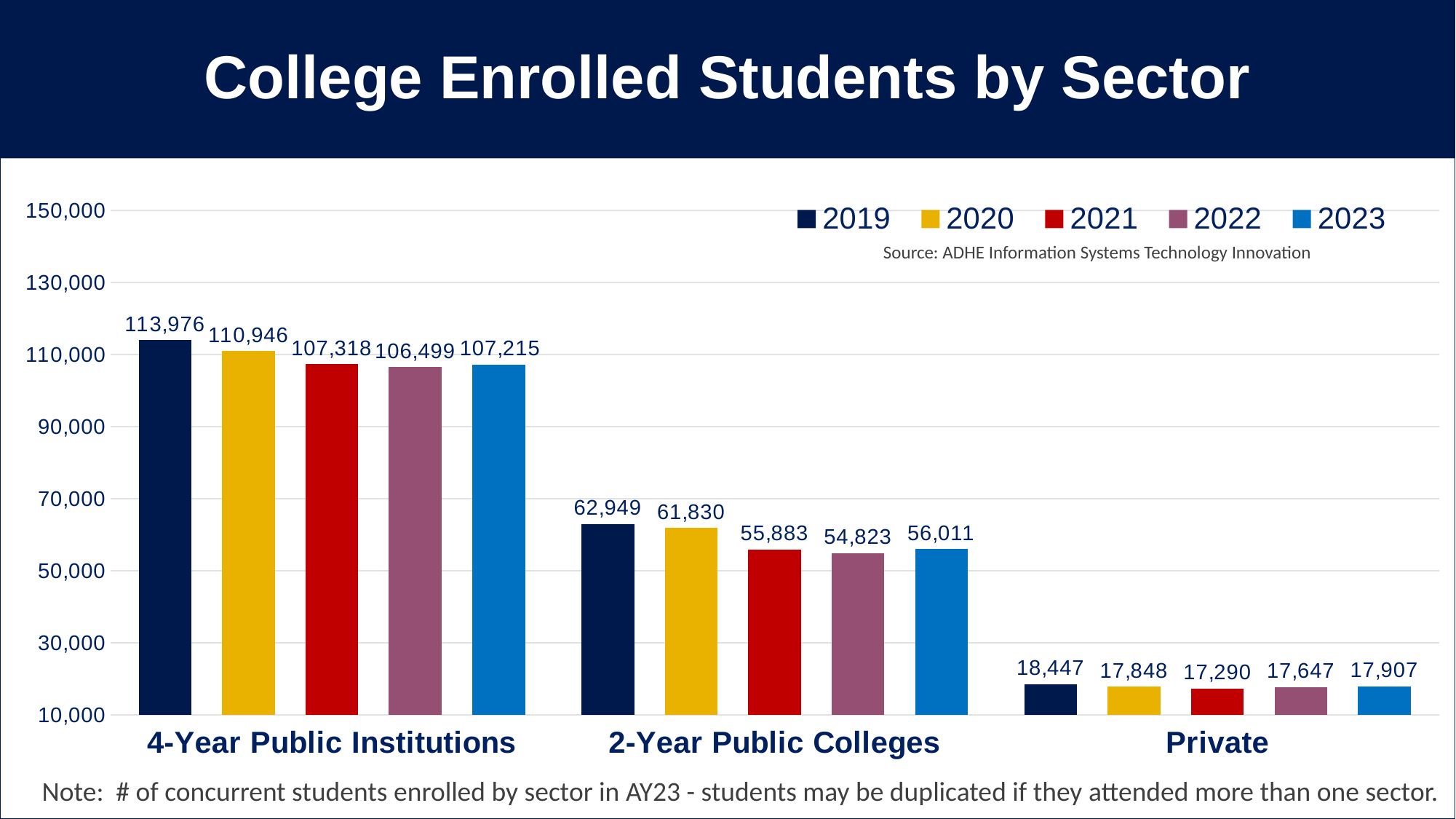
Which year had the lowest enrollment in the Private sector? 2021 Which year had the highest enrollment at 2-Year Public Colleges? 2019 What is the difference between 2019 and 2023 enrollment at 4-Year Public Institutions? 6,761 Which is larger: 2-Year Public Colleges enrollment in 2020 or in 2023? 2020 How many sectors are shown on the x axis? 3 What was the enrollment at 4-Year Public Institutions in 2019? 113,976 What kind of chart is shown on the slide? Bar chart How many series does the legend list? 5 What was the Private sector enrollment in 2023? 17,907 Is the 2021 value for 2-Year Public Colleges greater or less than 50,000? greater What is the title of the chart? College Enrolled Students by Sector What was the enrollment at 2-Year Public Colleges in 2022? 54,823